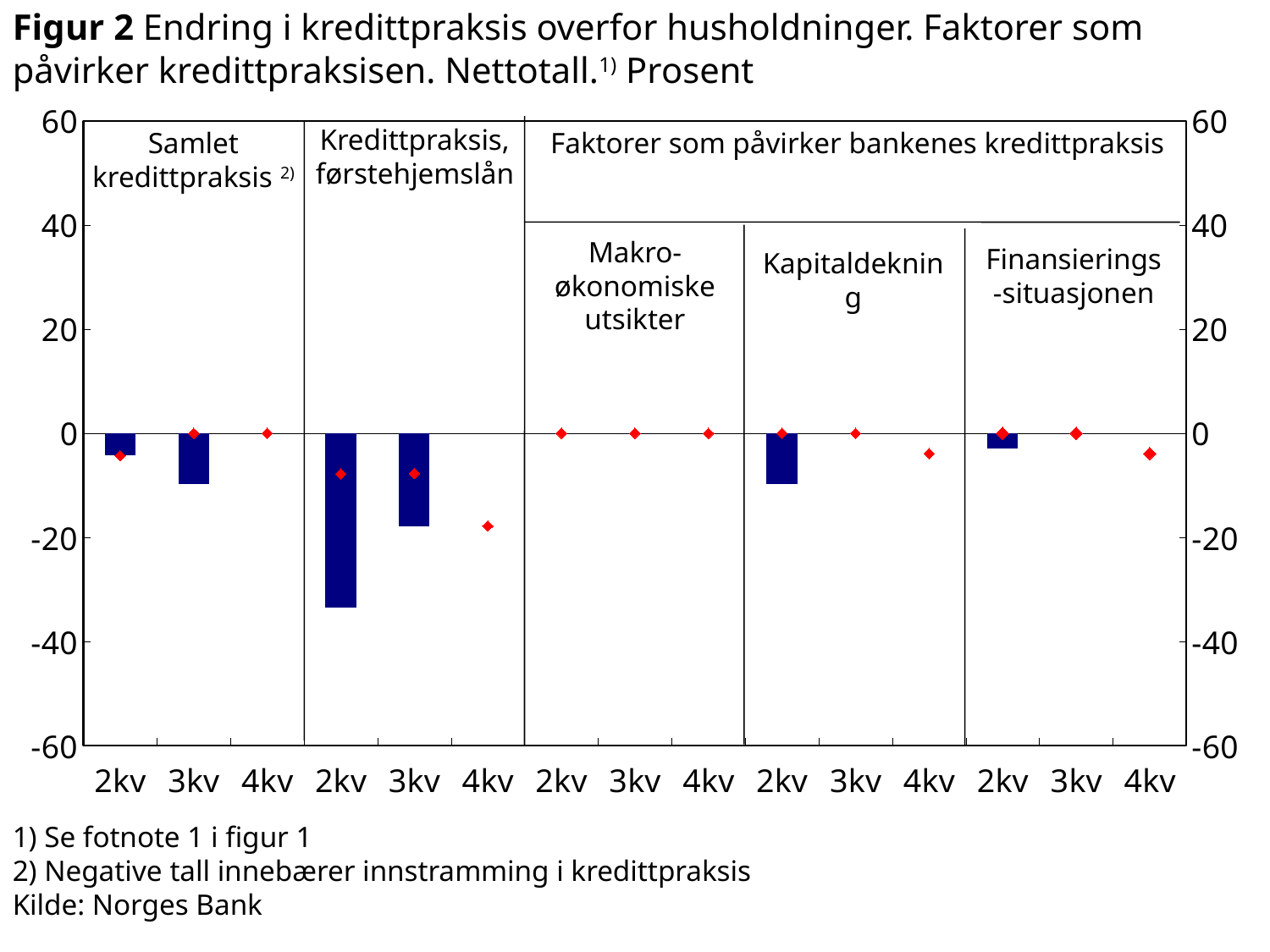
Is the bar for 2kv under Kapitaldekning greater or less than -20? greater Which bar is the lowest (most negative) in the chart? 2kv under Kredittpraksis, førstehjemslån Is the bar for 3kv under Kredittpraksis, førstehjemslån greater or less than -10? less Which factor panel shows no bars at all (all values at zero)? Makroøkonomiske utsikter Under Samlet kredittpraksis, which bar is more negative, 2kv or 3kv? 3kv Is the bar for 2kv under Kredittpraksis, førstehjemslån greater or less than -20? less How many quarter categories are shown along the x axis in total? 15 What is the maximum value shown on the vertical axis? 60 How many labelled panels (groups) is the chart divided into? 5 What kind of chart is shown on the slide? bar chart What is the source given for the chart? Norges Bank Under Kredittpraksis, førstehjemslån, do the bars rise or fall from 2kv to 4kv? rise